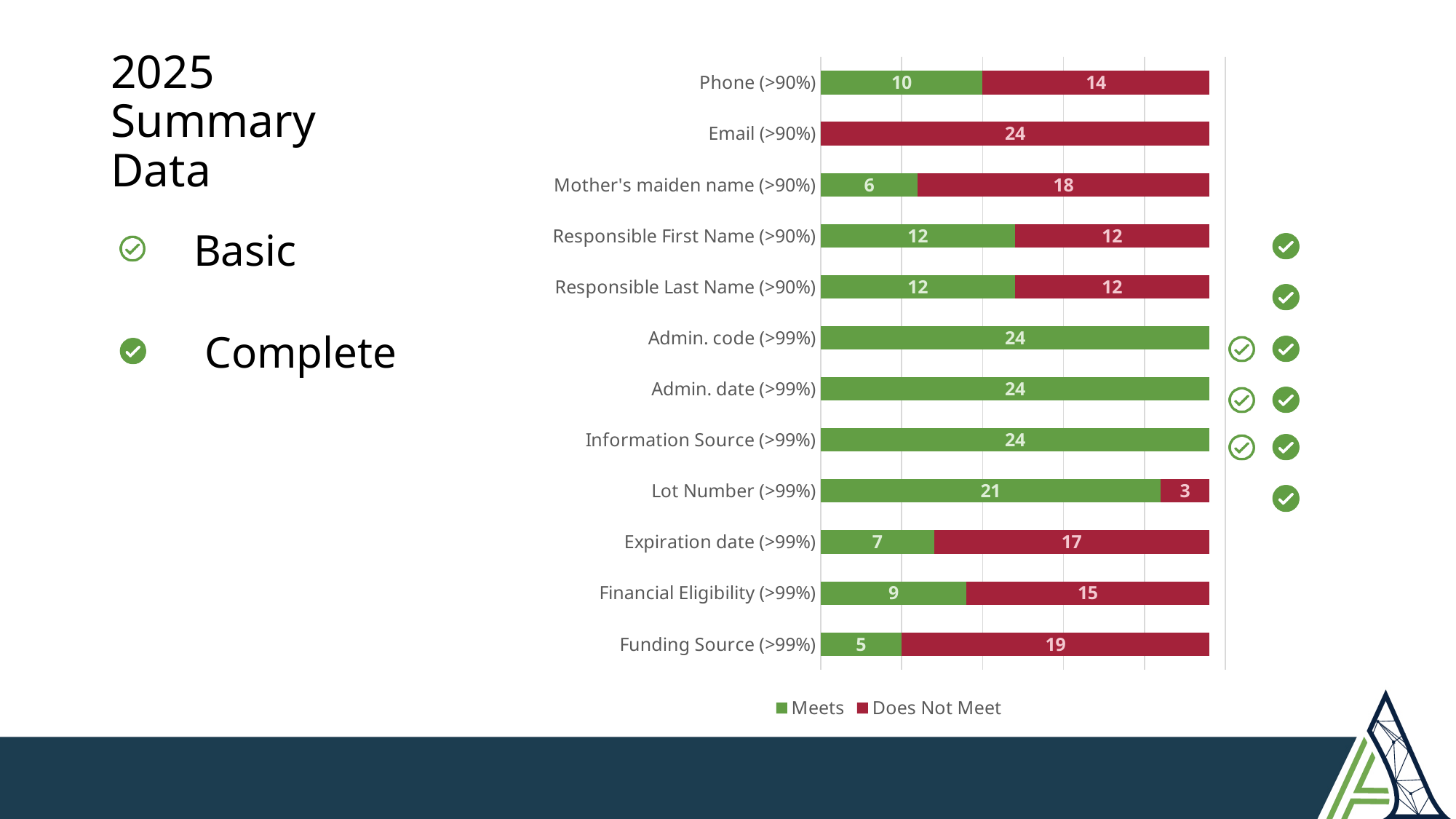
What is the total of the stacked bar for Lot Number (>99%)? 24 What is the 'Meets' value for Phone (>90%)? 10 What is the 'Meets' value for Funding Source (>99%)? 5 What is the 'Does Not Meet' value for Mother's maiden name (>90%)? 18 How many series does the legend list? 2 Which is larger for Financial Eligibility (>99%): 'Meets' or 'Does Not Meet'? Does Not Meet How many categories are shown in the chart? 12 What is the 'Meets' value for Lot Number (>99%)? 21 What is the difference between the 'Does Not Meet' and 'Meets' values for Expiration date (>99%)? 10 What kind of chart is shown on the slide? Stacked bar chart Which category has the lowest 'Meets' value? Email (>90%) What is the 'Does Not Meet' value for Email (>90%)? 24